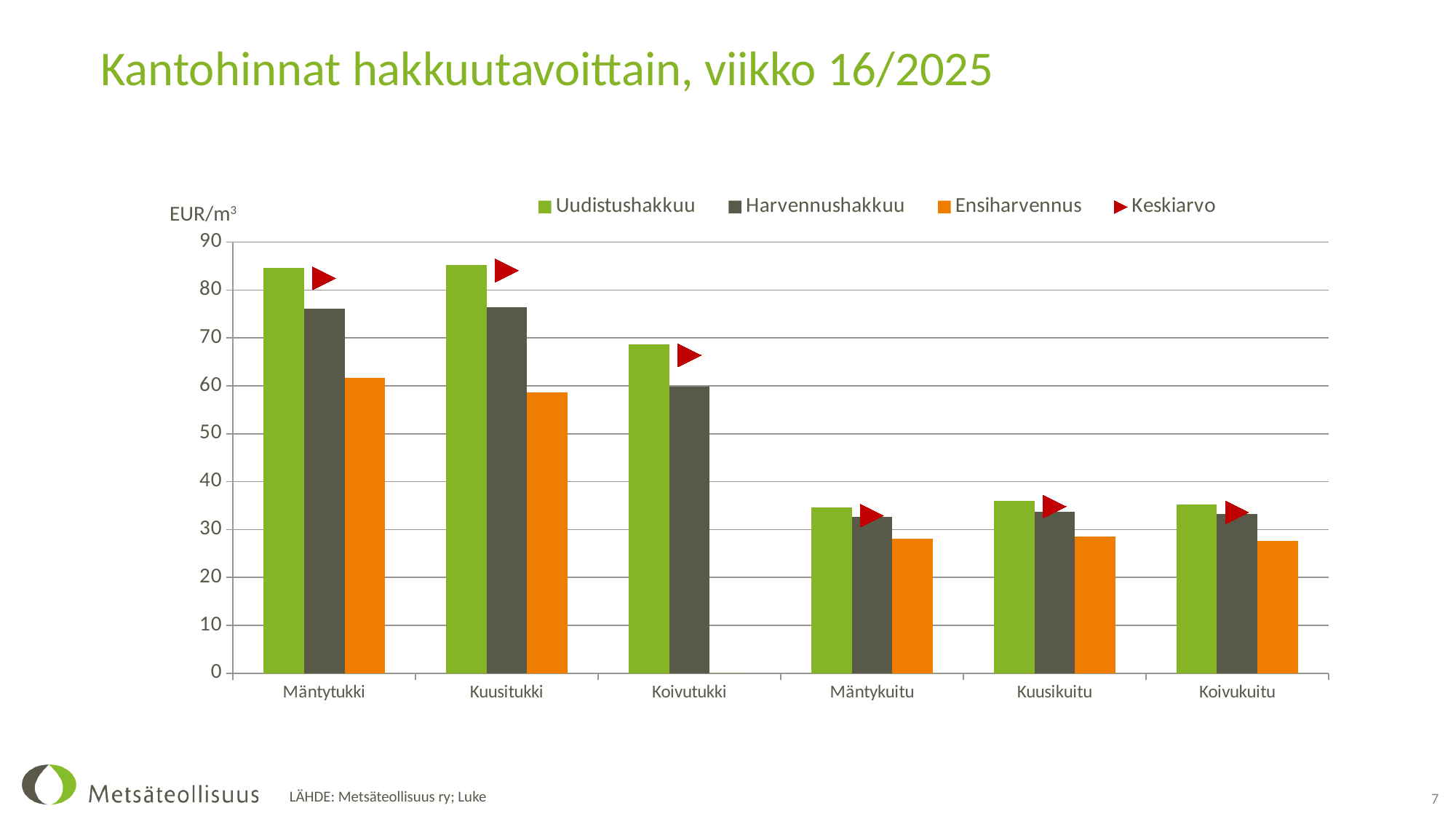
Is the Uudistushakkuu value for Mäntytukki greater or less than 80? greater What is the title of the chart? Kantohinnat hakkuutavoittain, viikko 16/2025 How many series does the legend list? 4 Is the Ensiharvennus value for Mäntykuitu greater or less than 30? less Which is larger, the Uudistushakkuu value for Kuusitukki or for Koivutukki? Kuusitukki What kind of chart is shown on the slide? bar chart Is the Uudistushakkuu value for Koivutukki greater or less than 70? less What unit is shown on the y axis? EUR/m³ Which category has the lowest Harvennushakkuu value among the tukki categories (Mäntytukki, Kuusitukki, Koivutukki)? Koivutukki Which category has the highest Ensiharvennus value? Mäntytukki How many categories are shown on the x axis? 6